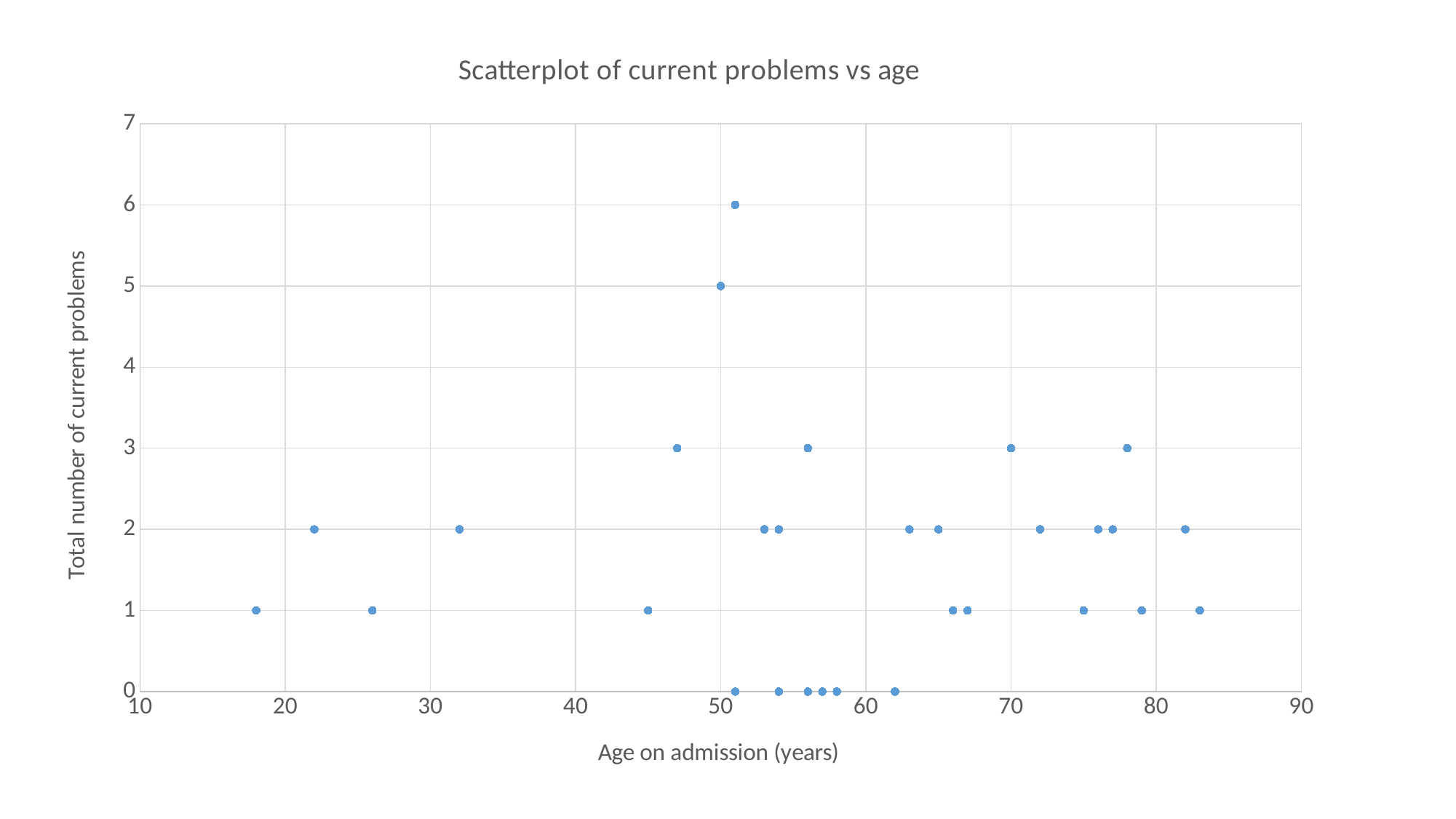
How many points are plotted at 3 current problems? 4 How many points are plotted at 5 or more current problems? 2 What is the maximum value shown on the y axis? 7 What kind of chart is shown on the slide? Scatter plot What is the highest total number of current problems plotted for any patient? 6 What is the lowest total number of current problems plotted for any patient? 0 What is the label of the x axis? Age on admission (years) Is the age of the patient with 5 current problems greater or less than 30? greater Is the age of the patient with 6 current problems greater or less than 40? greater Which has more current problems: the youngest patient (near age 18) or the patient near age 22? The patient near age 22 What is the title of the chart? Scatterplot of current problems vs age